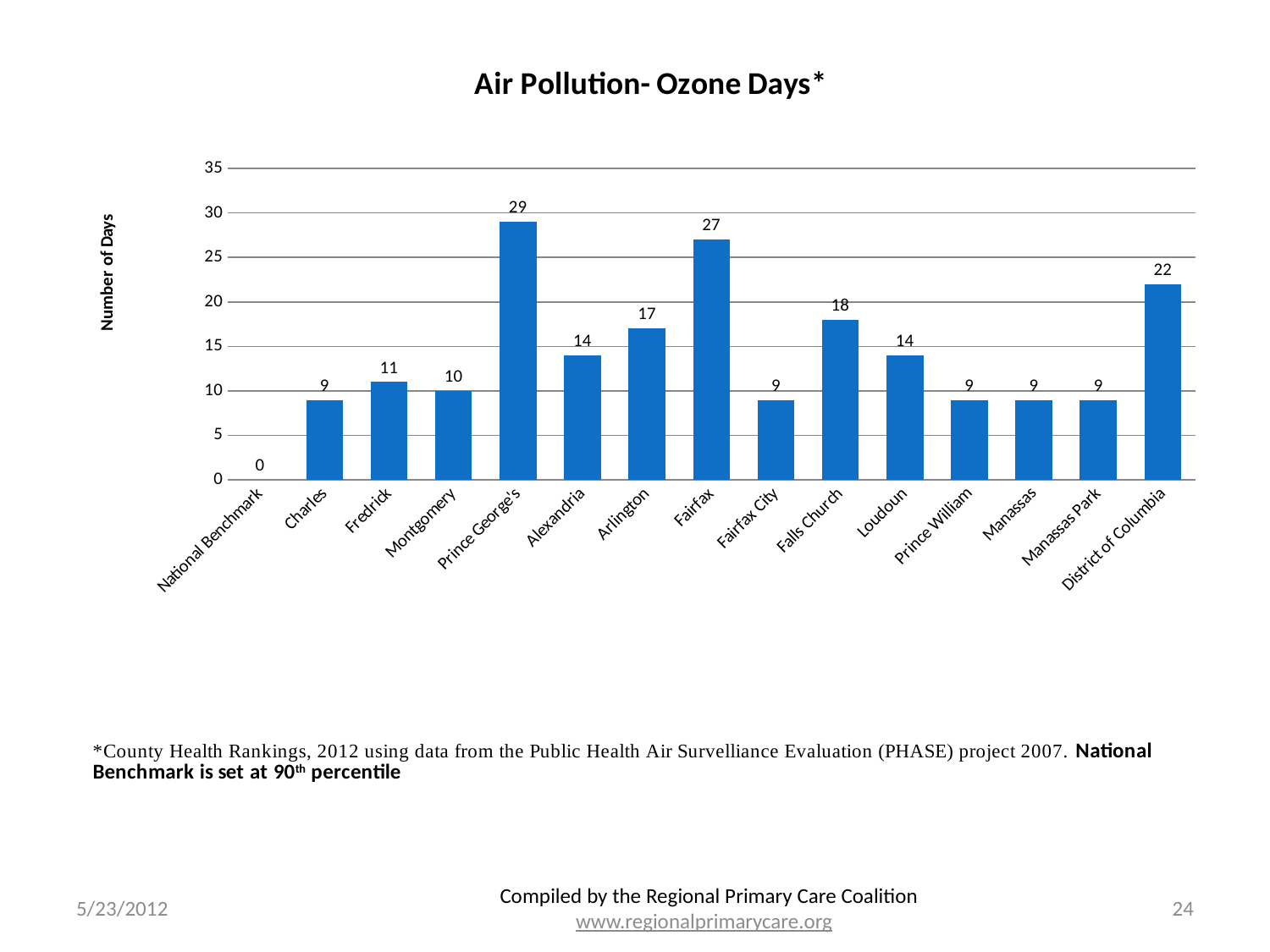
Which category has the highest number of ozone days? Prince George's What is the number of ozone days for Prince George's? 29 What is the difference in ozone days between District of Columbia and Montgomery? 12 Which has more ozone days, Falls Church or Loudoun? Falls Church What kind of chart is shown on the slide? Bar chart What is the value shown for the National Benchmark? 0 Which category has the lowest value on the chart? National Benchmark How many categories are shown on the x axis? 15 What is the difference in ozone days between Prince George's and Fairfax? 2 What is the title of the chart? Air Pollution- Ozone Days* What is the number of ozone days for District of Columbia? 22 What is the number of ozone days for Fairfax? 27